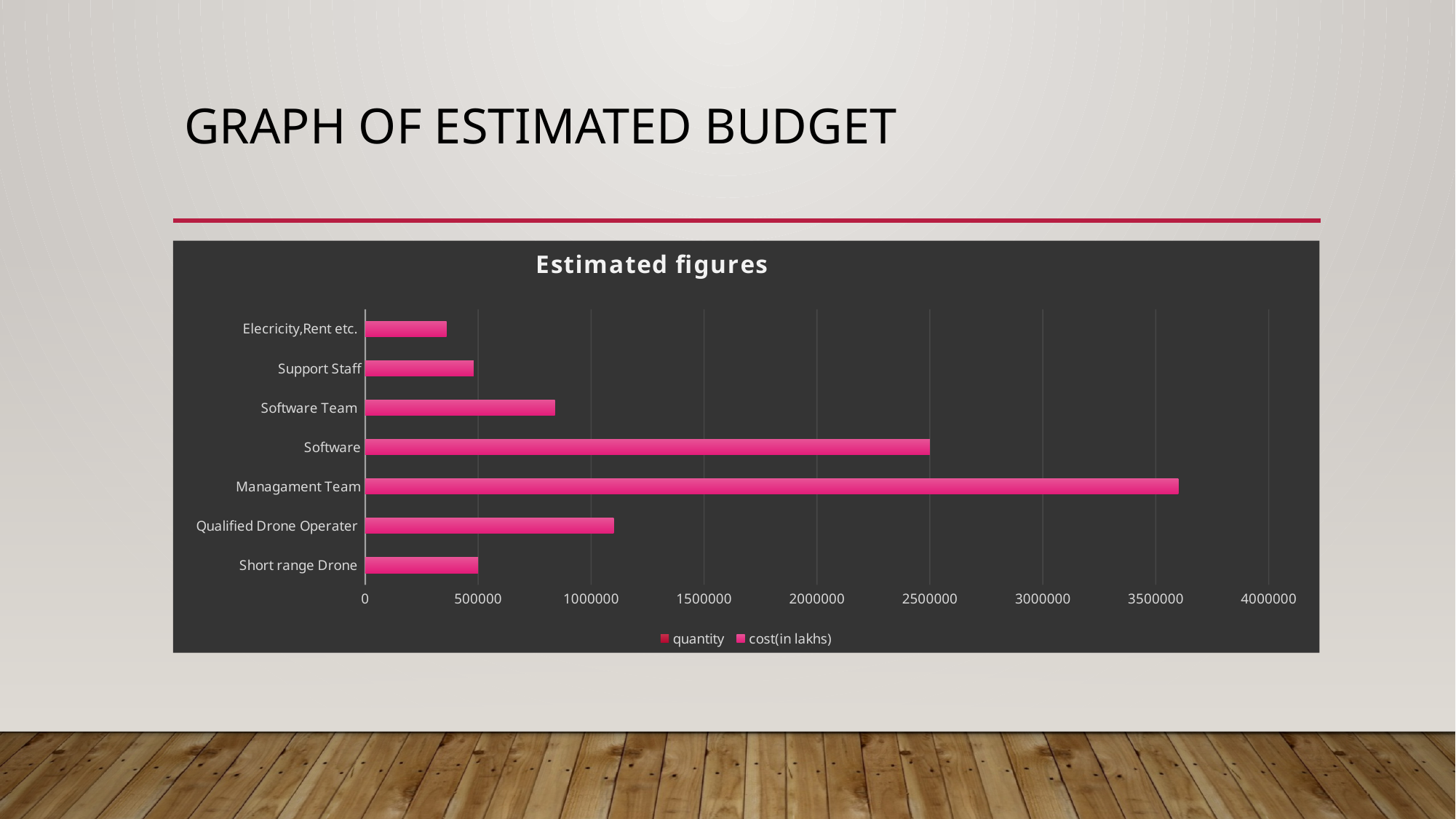
Is the value for Qualified Drone Operater greater or less than 1000000? greater Which category has the lowest value? Elecricity,Rent etc. What are the two entries listed in the legend? quantity and cost(in lakhs) What type of chart is shown on the slide? bar chart How many series does the legend list? 2 What is the title of the chart? Estimated figures Which is larger, the value for Software or the value for Software Team? Software How many categories are plotted on the chart? 7 Is the value for Managament Team greater or less than 3500000? greater Is the value for Software Team greater or less than 1000000? less Which category has the highest value? Managament Team